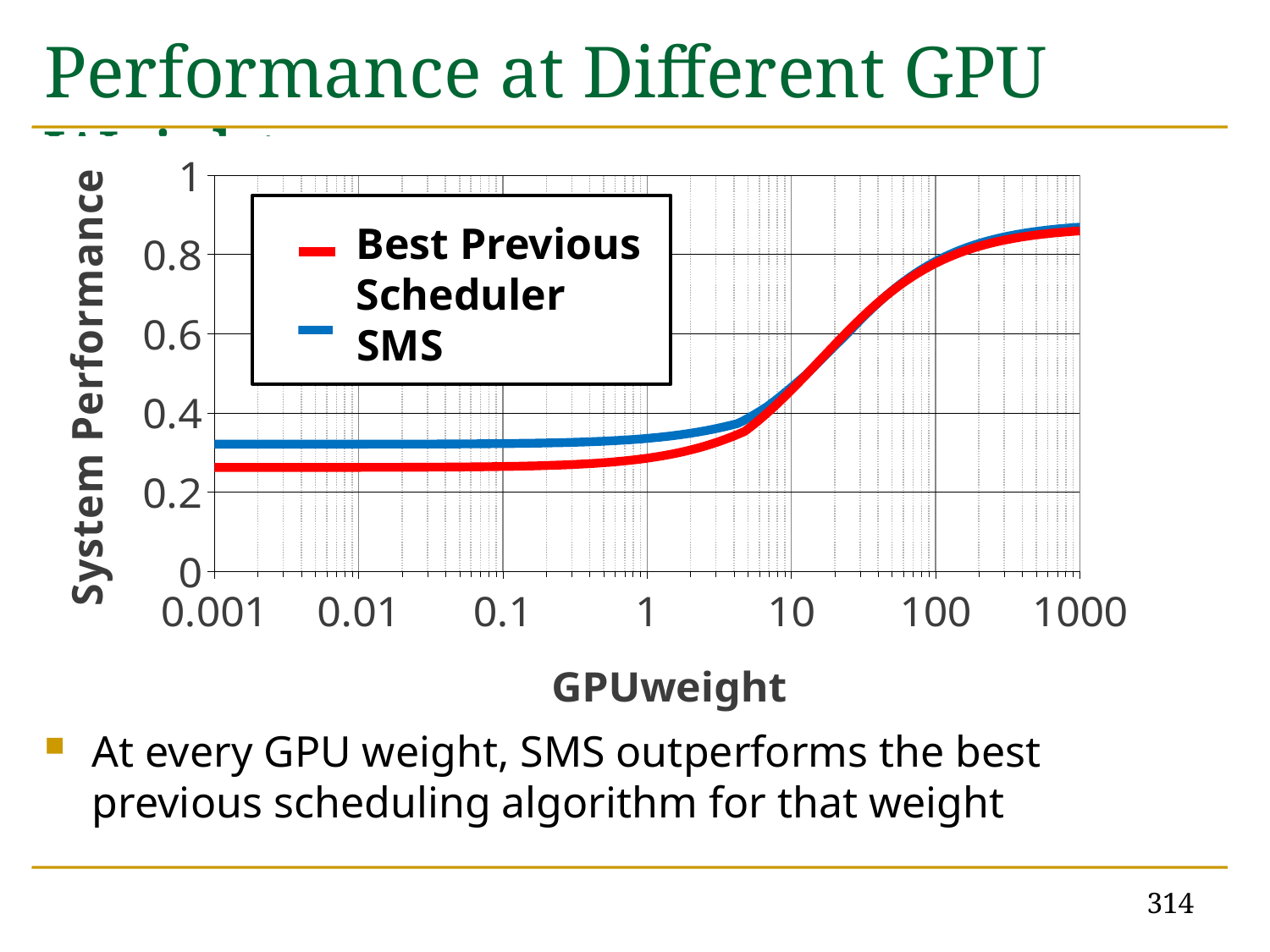
Do the System Performance values rise or fall as GPUweight increases? rise What are the two series named in the legend? Best Previous Scheduler and SMS Which series is drawn in red? Best Previous Scheduler Is the System Performance of Best Previous Scheduler at a GPUweight of 0.01 greater or less than 0.2? greater Is the System Performance of SMS at a GPUweight of 0.001 greater or less than 0.2? greater What is the label of the x axis? GPUweight At a GPUweight of 0.001, which series has the higher System Performance, SMS or Best Previous Scheduler? SMS Is the System Performance of SMS at a GPUweight of 0.001 greater or less than 0.4? less What kind of chart is shown on the slide? line chart How many series does the legend list? 2